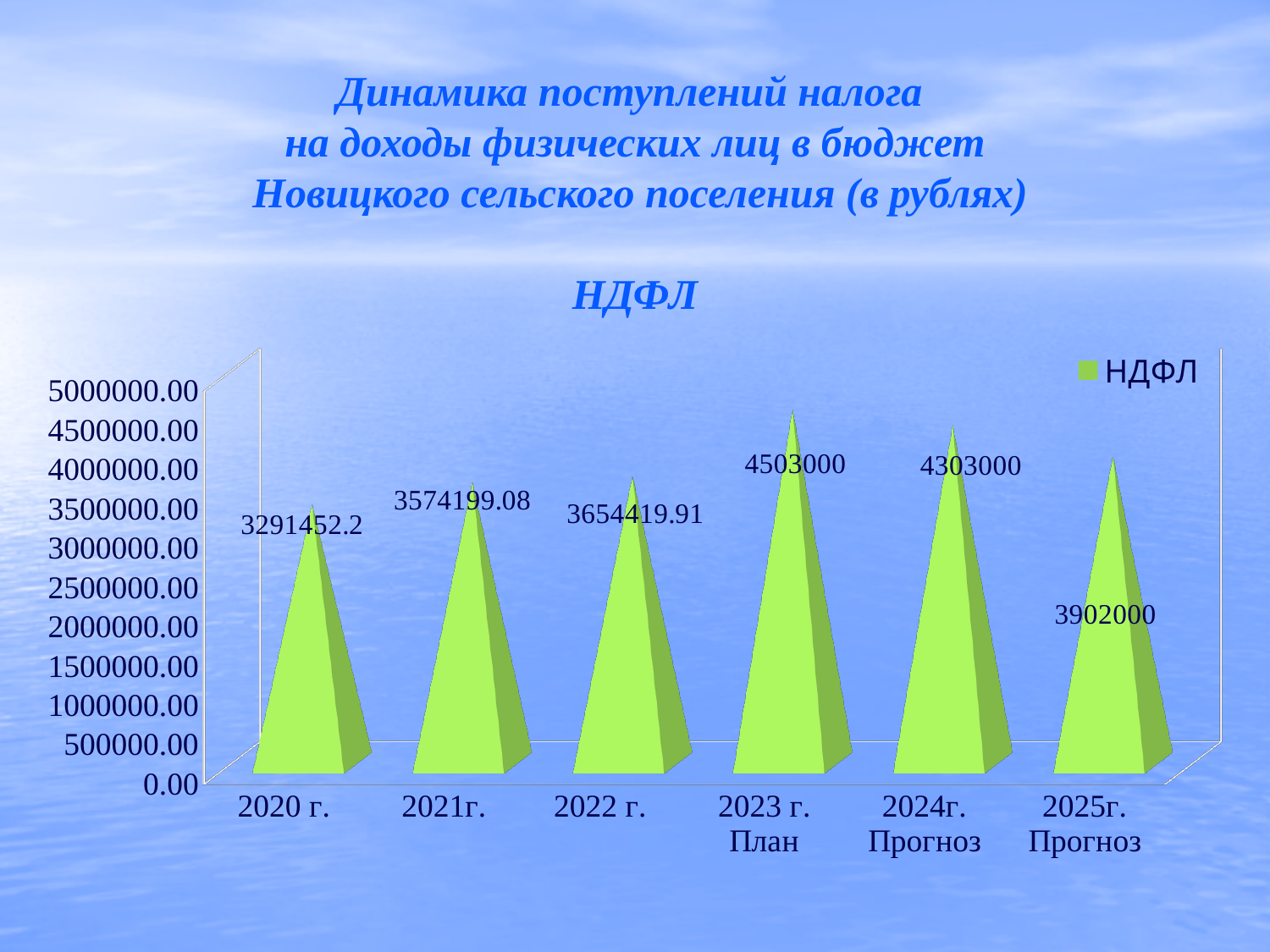
What is the value for 2023 г. План? 4503000 What is the value for 2025г. Прогноз? 3902000 How many categories are shown on the x axis? 6 What is the value for 2020 г.? 3291452.2 Which is larger, the value for 2024г. Прогноз or the value for 2025г. Прогноз? 2024г. Прогноз How many series does the legend list? 1 What is the difference between the values for 2023 г. План and 2024г. Прогноз? 200000 Do the values rise or fall from 2020 г. to 2023 г. План? rise Which category has the highest value? 2023 г. План Is the value for 2022 г. greater or less than 4000000.00? less What kind of chart is shown? bar chart Which category has the lowest value? 2020 г.